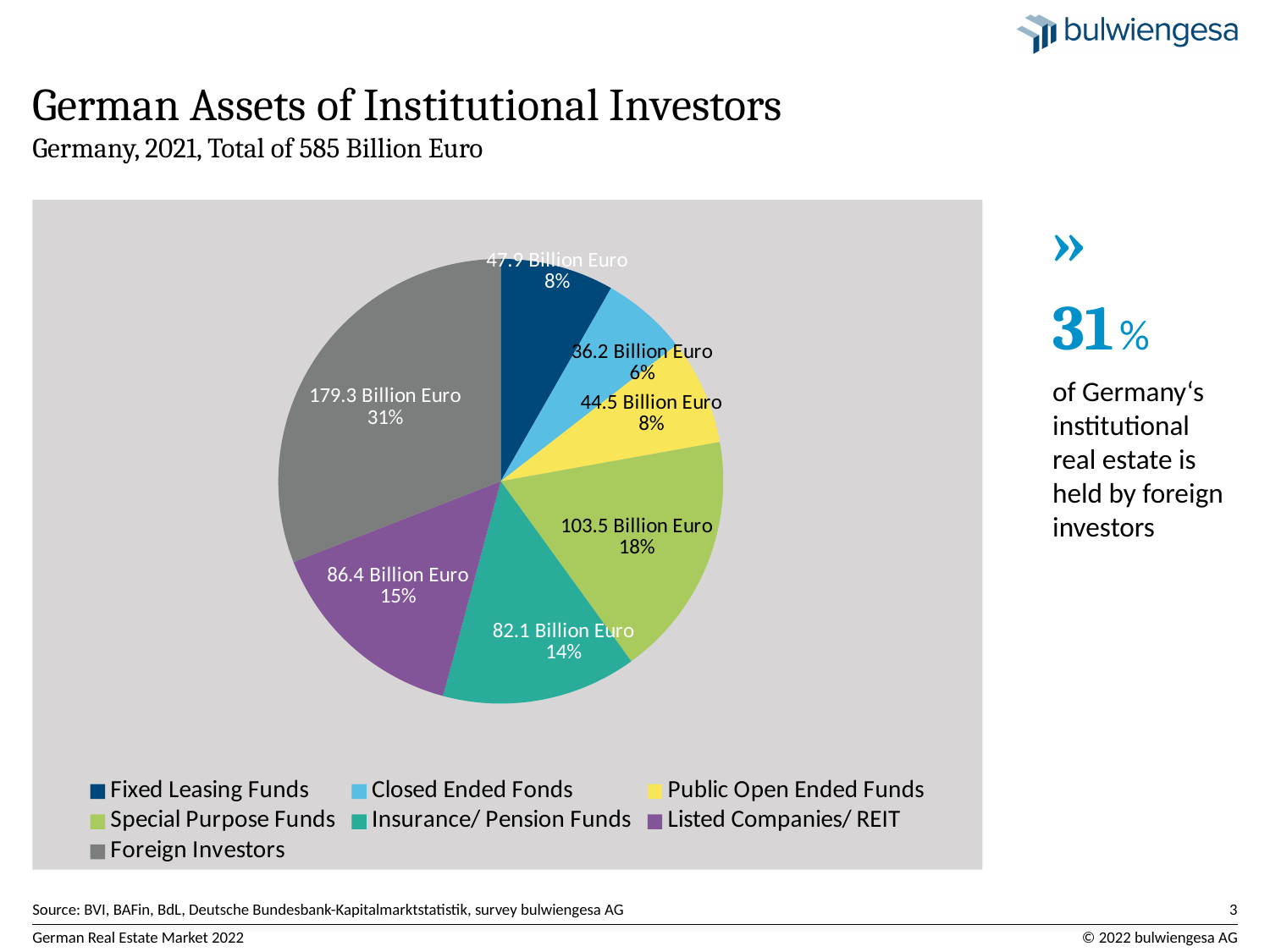
Which category has the smallest share of the pie? Closed Ended Fonds What is the difference between the values for Foreign Investors and Special Purpose Funds? 75.8 Billion Euro What is the value for Listed Companies/ REIT? 86.4 Billion Euro What is the value for Foreign Investors? 179.3 Billion Euro What share of the pie does Special Purpose Funds hold? 18% How many categories does the pie chart show? 7 Which is larger, the value for Listed Companies/ REIT or Insurance/ Pension Funds? Listed Companies/ REIT What kind of chart is shown on the slide? Pie chart What share of the pie does Insurance/ Pension Funds hold? 14% What is the value for Closed Ended Fonds? 36.2 Billion Euro Which category has the largest share of the pie? Foreign Investors What is the value for Special Purpose Funds? 103.5 Billion Euro